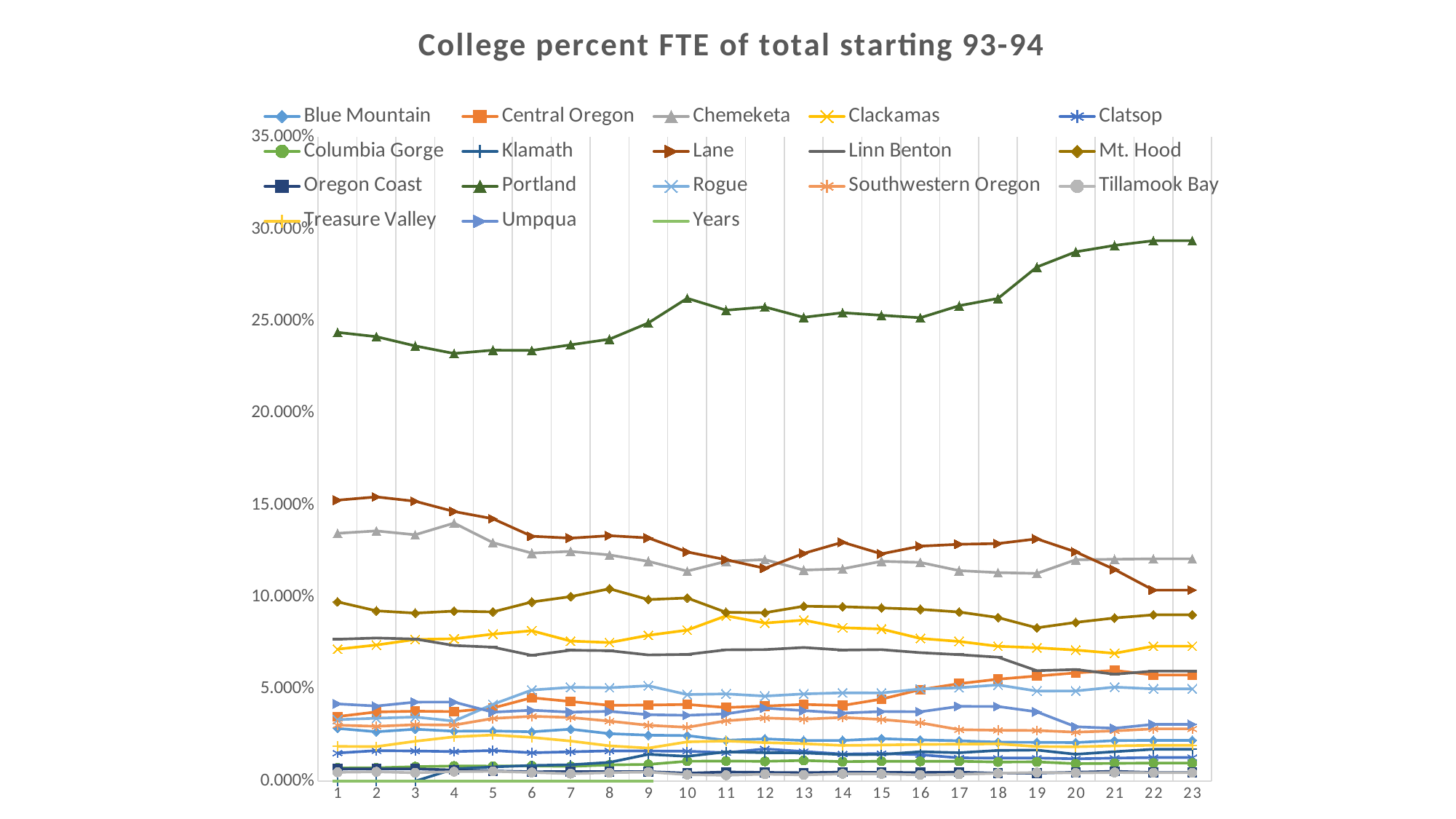
Which series has the highest value at point 23? Portland Is the value for Mt. Hood at point 23 greater or less than 10%? less What is the title of the chart? College percent FTE of total starting 93-94 At point 1, which is larger: Lane or Chemeketa? Lane How many points are there along the x axis? 23 What kind of chart is shown on the slide? line chart Is the value for Portland at point 23 greater or less than 25%? greater Is the value for Lane at point 1 greater or less than 10%? greater How many series does the legend list? 18 Does the Portland series rise or fall overall from point 1 to point 23? rise